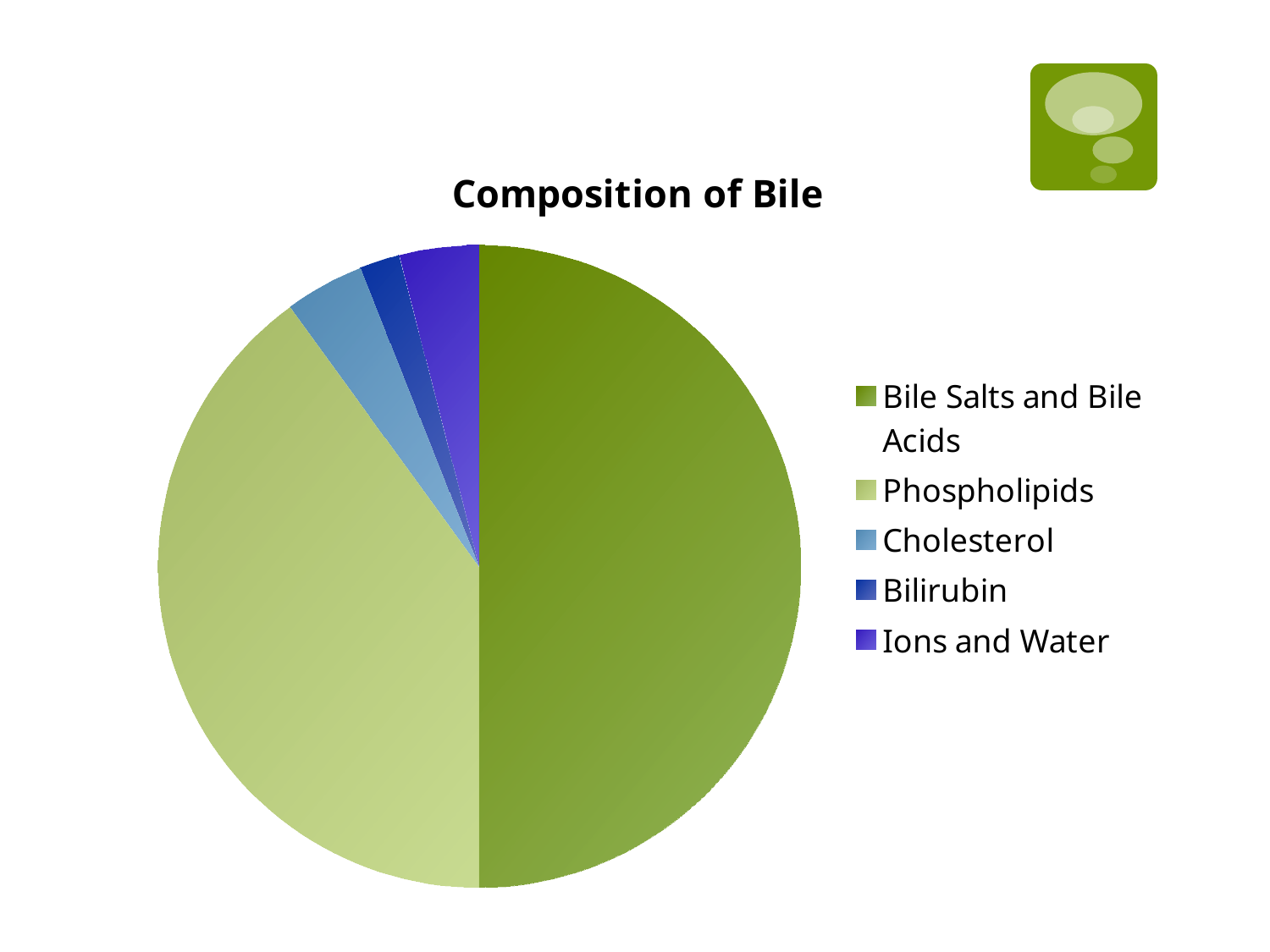
Which component is the second-largest slice of the pie? Phospholipids Which component has the largest slice of the pie? Bile Salts and Bile Acids What is the title of the chart? Composition of Bile Which slice is larger, Cholesterol or Bilirubin? Cholesterol What kind of chart is shown on the slide? pie chart How many entries does the legend list? 5 Which slice is larger, Phospholipids or Cholesterol? Phospholipids How many slices does the pie chart have? 5 Which slice is larger, Bile Salts and Bile Acids or Phospholipids? Bile Salts and Bile Acids Which legend entry is listed last? Ions and Water Which component has the smallest slice of the pie? Bilirubin